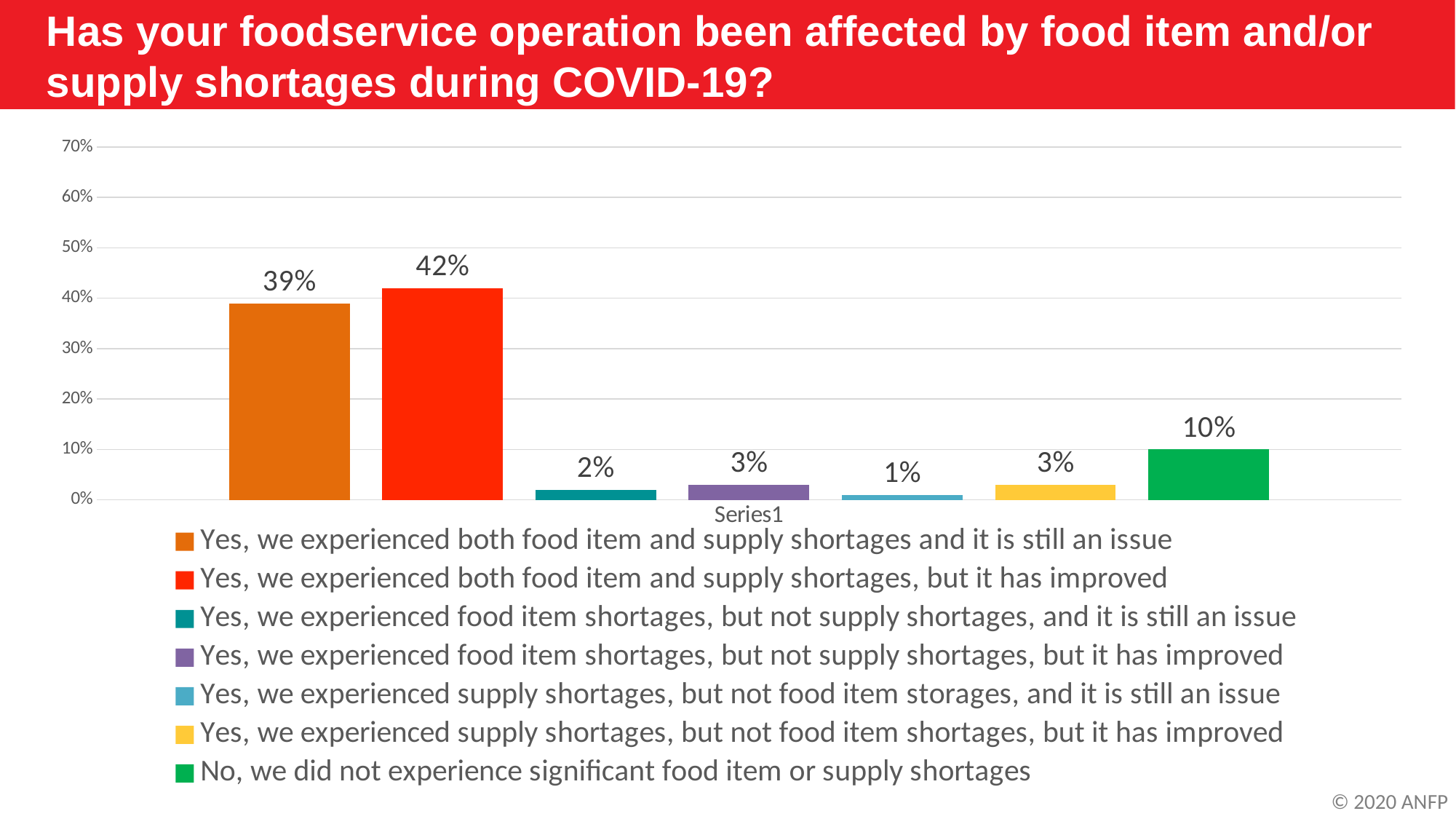
How many response categories are shown in the chart? 7 Which response has the highest percentage? Yes, we experienced both food item and supply shortages, but it has improved What colour is the bar for 'No, we did not experience significant food item or supply shortages'? Green Which response has the lowest percentage? Yes, we experienced supply shortages, but not food item storages, and it is still an issue What percentage of respondents said they experienced supply shortages, but not food item shortages, and it is still an issue? 1% Is the value for 'both food item and supply shortages, but it has improved' greater or less than 40%? greater Which is larger: the percentage for 'No, we did not experience significant food item or supply shortages' or for 'food item shortages, but not supply shortages, but it has improved'? No, we did not experience significant food item or supply shortages What percentage of respondents said they did not experience significant food item or supply shortages? 10% What percentage of respondents said they experienced both food item and supply shortages, but it has improved? 42% What is the difference between the percentage for 'both shortages, but it has improved' and 'both shortages and it is still an issue'? 3% What percentage of respondents said they experienced both food item and supply shortages and it is still an issue? 39% What type of chart is shown on the slide? Bar chart